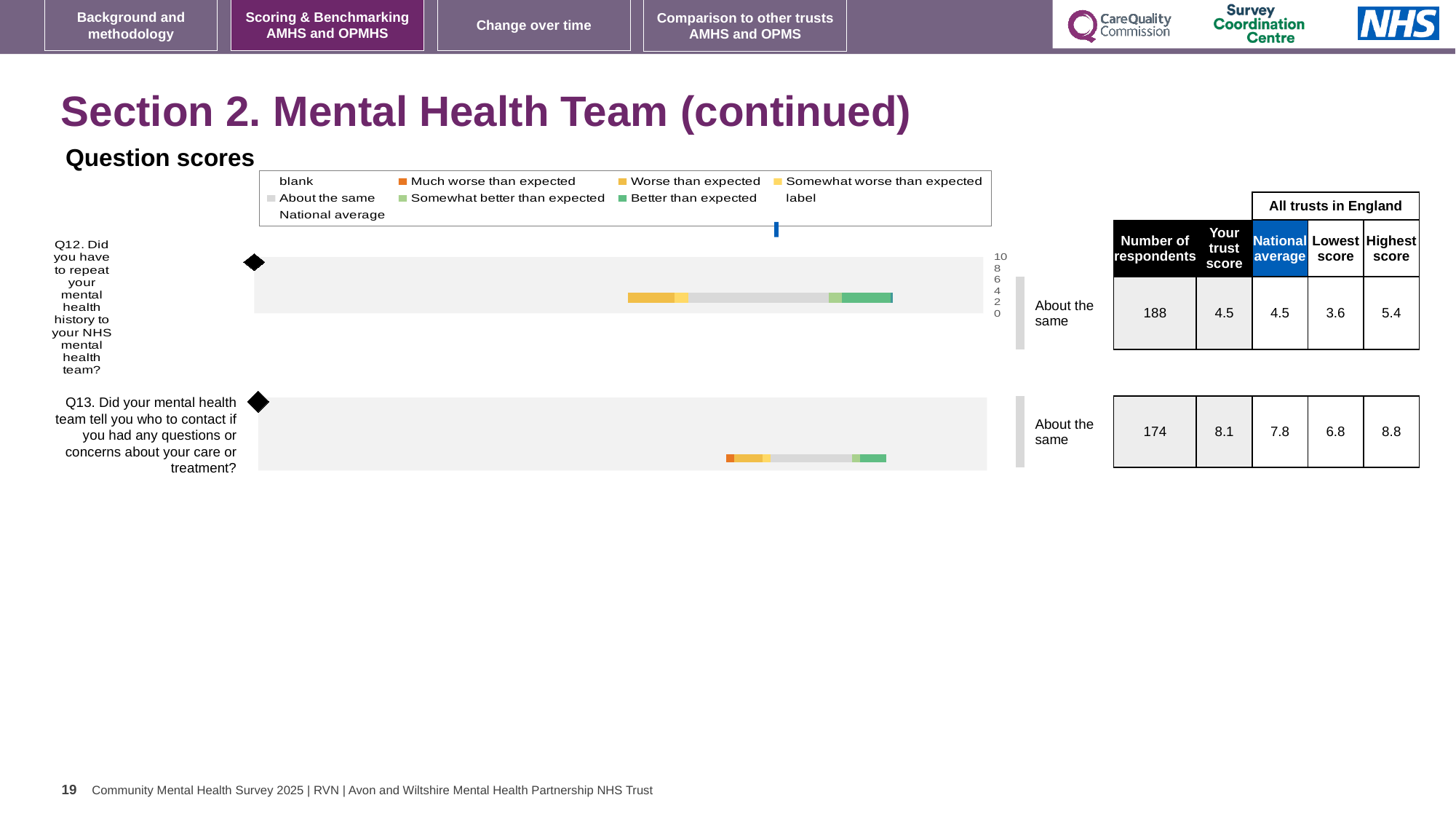
What is the difference between the highest score and the lowest score for Q12? 1.8 What kind of chart is used to show the question scores on this slide? bar chart What is the national average for Q12? 4.5 What is the number of respondents for Q12? 188 What is the highest score among all trusts in England for Q13? 8.8 What colour represents 'Much worse than expected' in the chart legend? orange What is the highest value shown on the chart's numeric axis? 10 How many questions (Q12 and Q13) are plotted in the question scores chart? 2 What rating label is shown next to the bar for Q13? About the same What rating label is shown next to the bar for Q12? About the same For Q13, which is larger: your trust score or the national average? Your trust score What is your trust score for Q13? 8.1